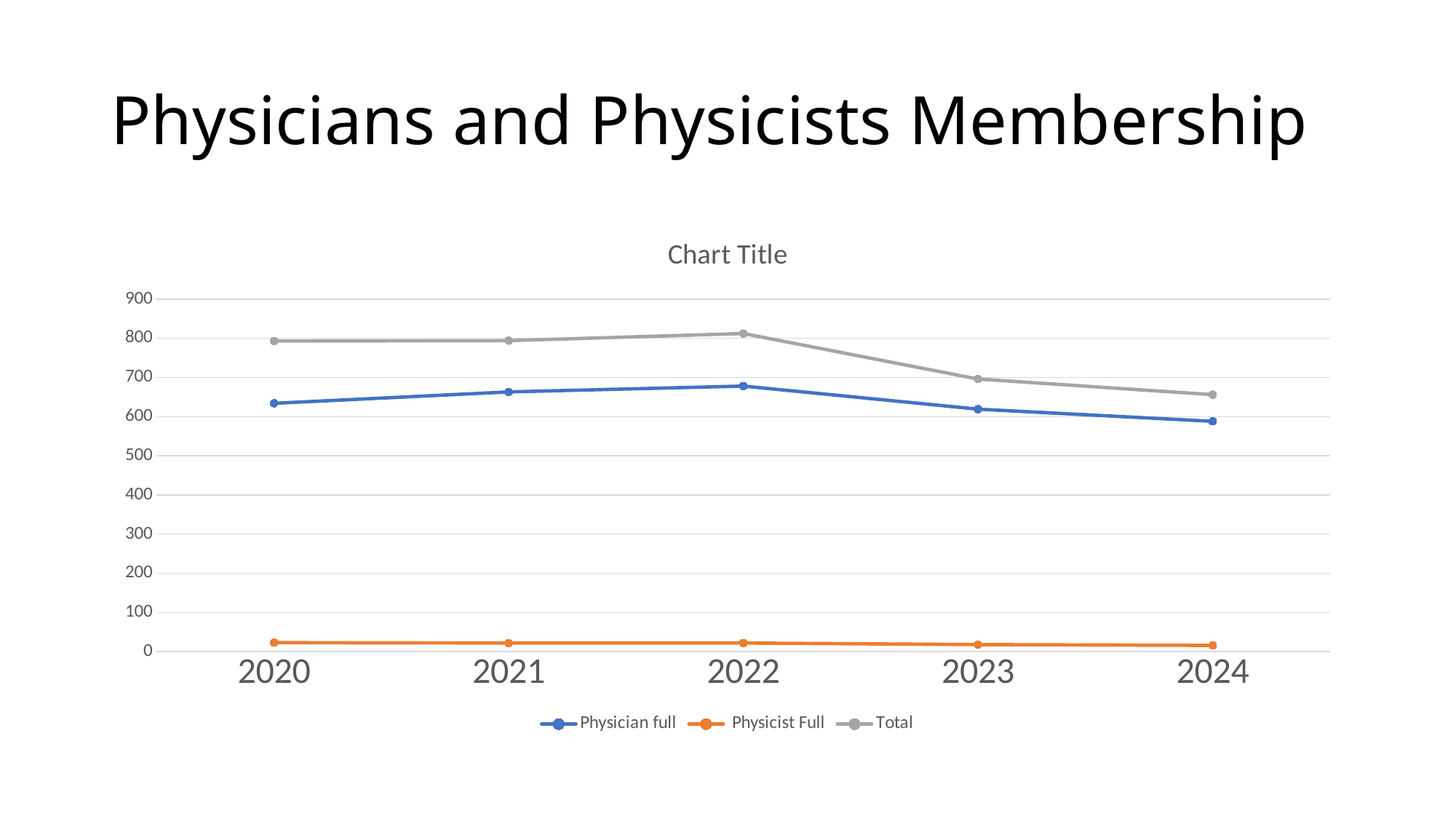
Does the Total series rise or fall from 2022 to 2024? fall How many series does the legend list? 3 Which is larger, the Total value in 2021 or in 2023? 2021 What colour is the line for the Total series? grey Is the value for Physicist Full in 2022 greater or less than 100? less What kind of chart is shown on the slide? line chart In which year is the Physician full series at its lowest? 2024 Is the value for Total in 2024 greater or less than 700? less In which year is the Total series at its highest? 2022 Is the value for Physician full in 2020 greater or less than 600? greater How many years are plotted along the x axis? 5 In which year is the Total series at its lowest? 2024